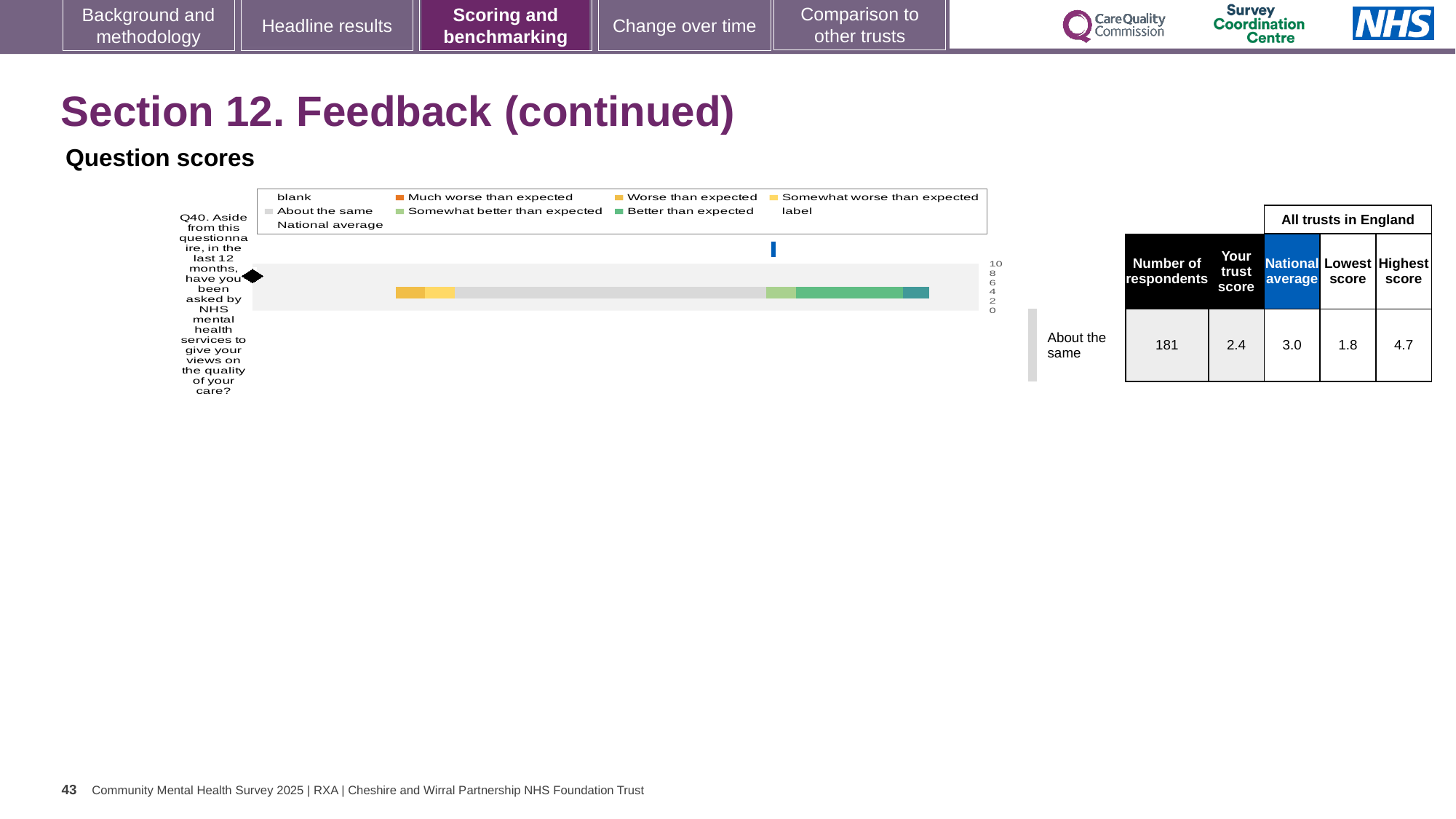
How many questions are plotted in the chart? 1 For Q40, what is the difference between the highest score and the lowest score among all trusts in England? 2.9 Which question number does the bar in the chart represent? Q40 In the table beside the chart, what is the lowest score among all trusts in England for Q40? 1.8 In the table beside the chart, what is the highest score among all trusts in England for Q40? 4.7 In the table beside the chart, what is the number of respondents for Q40? 181 In the table beside the chart, what is the national average for Q40? 3.0 For Q40, which is larger: your trust score or the national average? National average In the table beside the chart, what is your trust score for Q40? 2.4 What kind of chart is shown on the slide? bar chart For Q40, what is the difference between the national average and your trust score? 0.6 What benchmark category is shown next to the chart for Q40? About the same